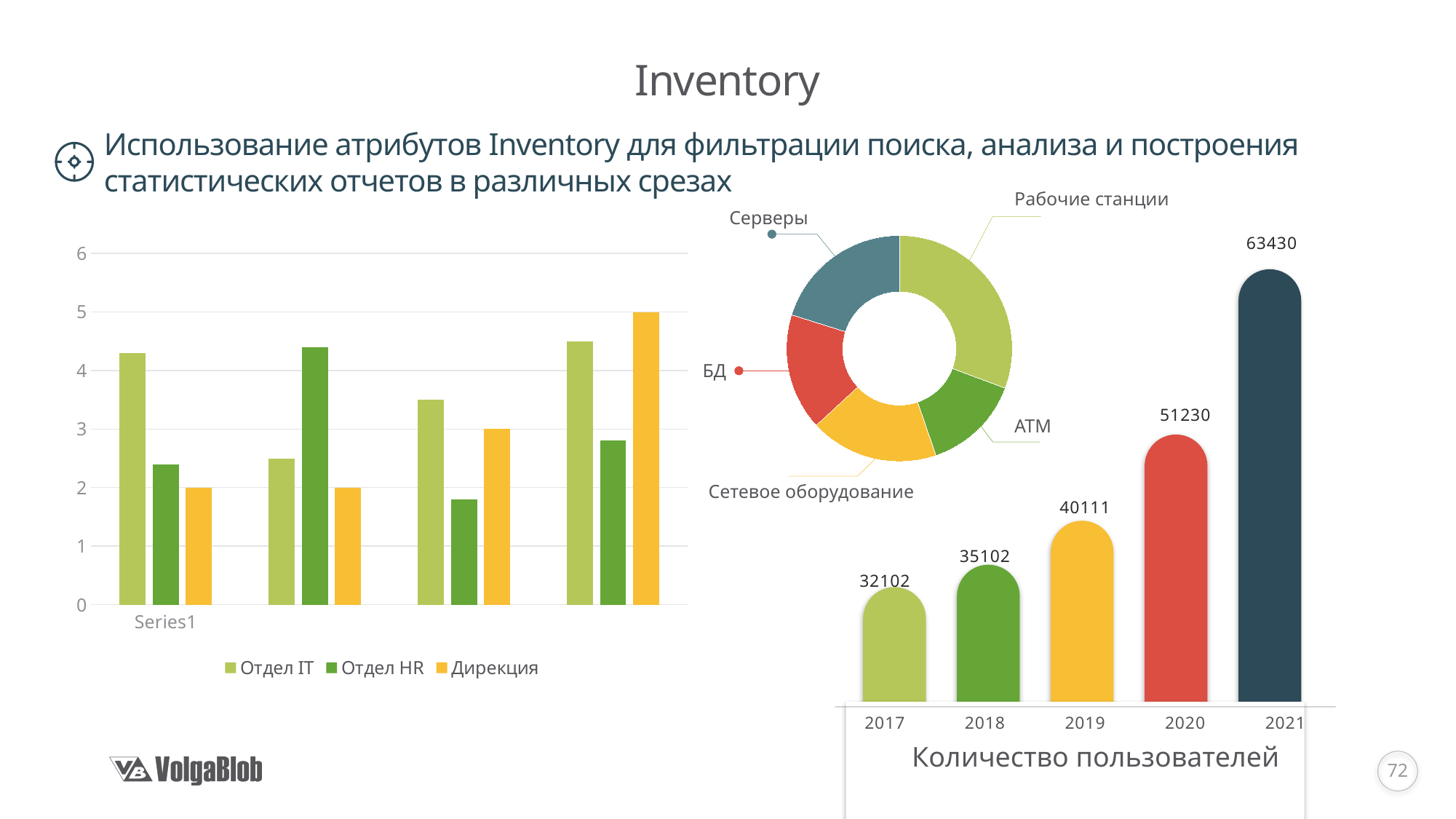
How many slices does the donut chart in the middle of the slide have? 5 In the 'Количество пользователей' chart, which year has the highest value? 2021 In the bar chart on the left, is the value for Дирекция in Series1 greater or less than 3? less How many years are shown in the 'Количество пользователей' chart? 5 In the 'Количество пользователей' chart, do the values rise or fall from 2017 to 2021? rise In the 'Количество пользователей' chart, which year has the lowest value? 2017 In the donut chart in the middle of the slide, which category has the largest slice? Рабочие станции How many series does the legend of the bar chart on the left list? 3 In the 'Количество пользователей' chart, which is larger, the value for 2018 or the value for 2019? 2019 In the 'Количество пользователей' chart, what is the value for 2021? 63430 In the 'Количество пользователей' chart, what is the value for 2019? 40111 In the 'Количество пользователей' chart, what is the difference between the values for 2021 and 2020? 12200